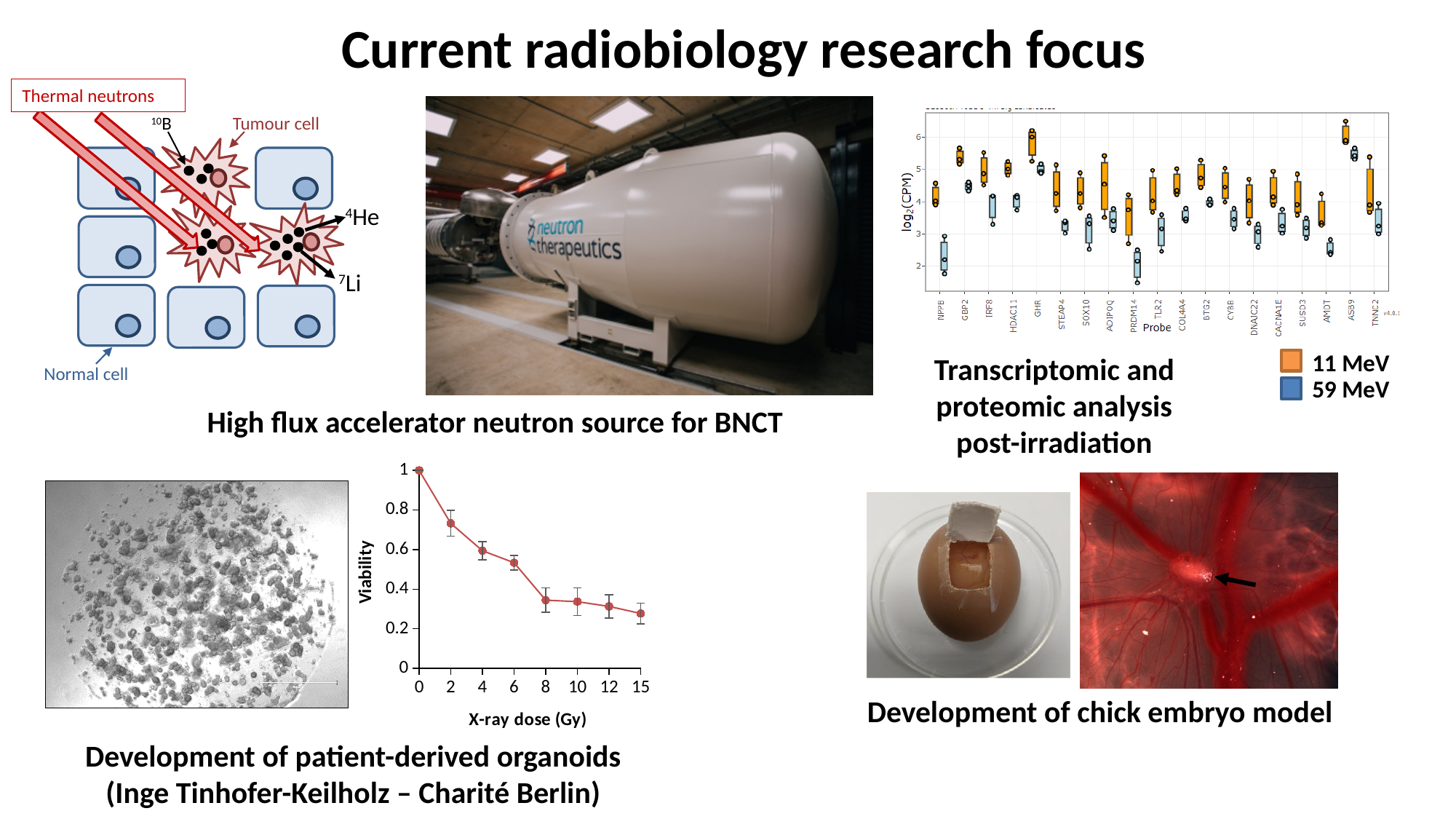
In the viability chart, is the viability at 8 Gy greater or less than 0.4? less How many data points are plotted in the viability versus X-ray dose chart? 8 In the transcriptomic box plot at the top right, which series has the higher log2(CPM) for NPPB, 11 MeV or 59 MeV? 11 MeV In the viability chart, which dose has the lowest viability? 15 Gy How many series does the legend of the transcriptomic box plot at the top right list? 2 In the transcriptomic box plot at the top right, which probe has the highest log2(CPM) for the 11 MeV series? ASB9 In the viability chart, is the viability at 15 Gy greater or less than 0.2? greater In the viability chart, what is the viability at an X-ray dose of 0 Gy? 1 In the viability chart, is the viability at 2 Gy greater or less than 0.6? greater What kind of chart is the viability versus X-ray dose chart at the bottom of the slide? line chart In the viability chart, how does viability change as the X-ray dose increases? It decreases What is the x-axis label of the viability chart? X-ray dose (Gy)